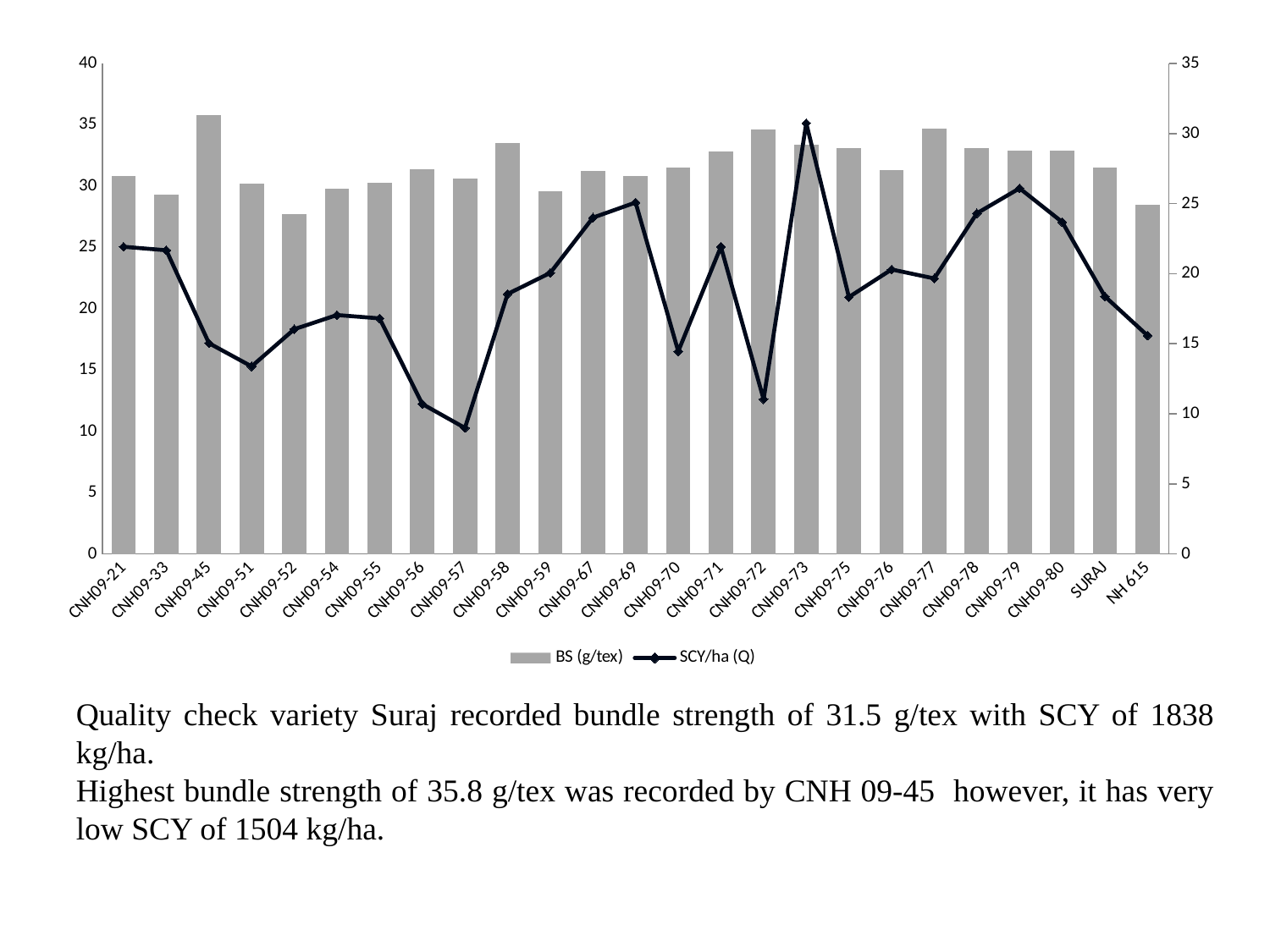
How many categories are shown on the x axis? 25 Is the SCY/ha (Q) value for CNH09-73 greater or less than 25? greater Is the BS (g/tex) value for CNH09-52 greater or less than 30? less What kind of chart is shown on the slide? A combined bar and line chart Which category has the highest SCY/ha (Q) value? CNH09-73 Which has the larger BS (g/tex) value, CNH09-45 or CNH09-33? CNH09-45 Which category has the highest BS (g/tex) bar? CNH09-45 What are the two series named in the legend? BS (g/tex) and SCY/ha (Q) Is the SCY/ha (Q) value for CNH09-72 greater or less than 15? less How many series does the legend list? 2 Which category has the lowest SCY/ha (Q) value? CNH09-57 Which has the larger SCY/ha (Q) value, CNH09-69 or CNH09-70? CNH09-69